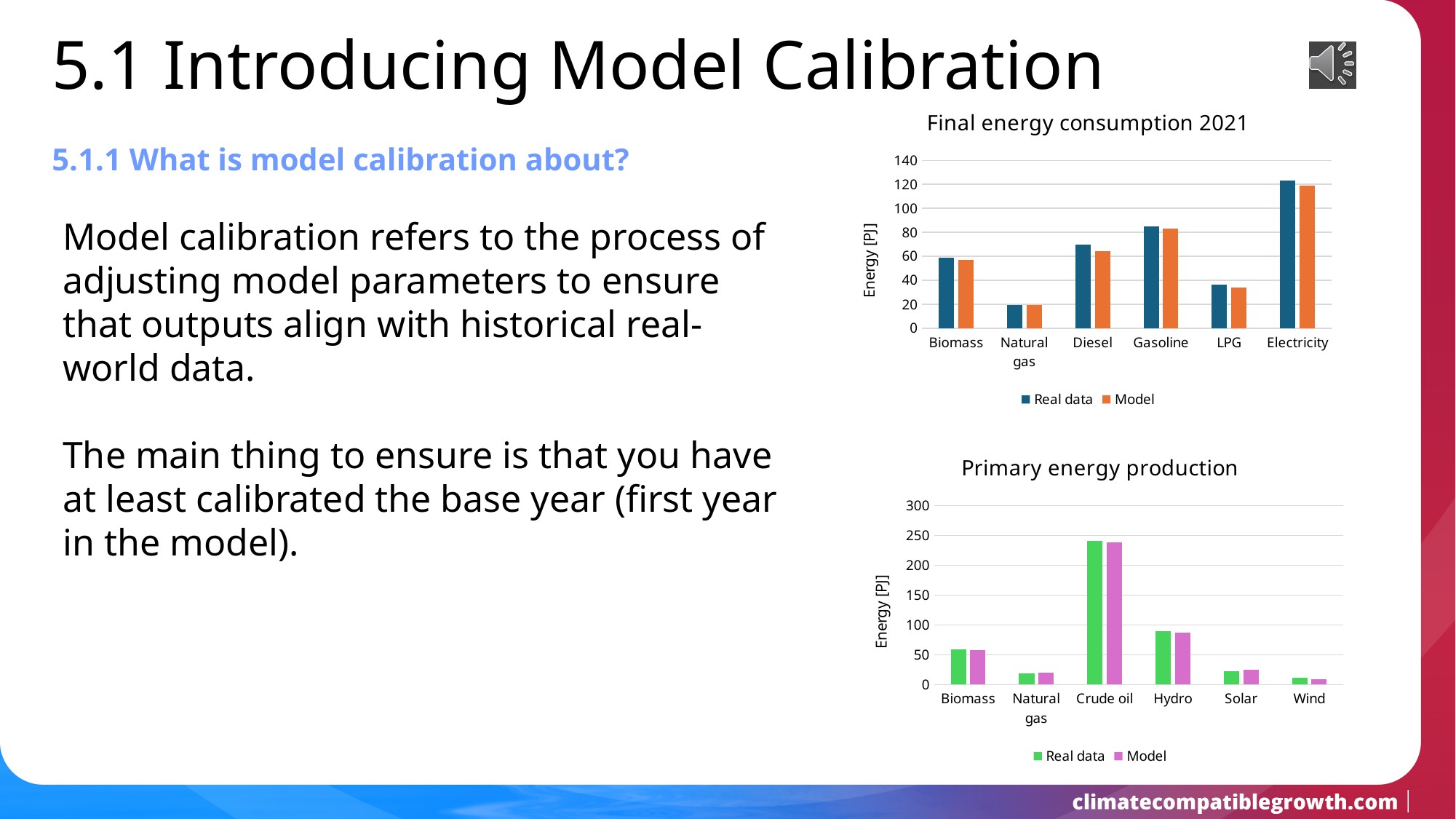
What kind of chart is the 'Final energy consumption 2021' chart? bar chart In the 'Final energy consumption 2021' chart, which category has the lowest Real data value? Natural gas In the 'Primary energy production' chart, which category has the lowest Real data value? Wind What is the y-axis label of the 'Primary energy production' chart? Energy [PJ] In the 'Final energy consumption 2021' chart, which is larger: the Real data value for Gasoline or the Real data value for LPG? Gasoline In the 'Final energy consumption 2021' chart, which category has the highest Real data value? Electricity How many series does the legend of the 'Primary energy production' chart list? 2 In the 'Final energy consumption 2021' chart, is the Real data value for Electricity greater or less than 100? greater In the 'Final energy consumption 2021' chart, is the Model value for Natural gas greater or less than 40? less How many categories are shown on the x axis of the 'Final energy consumption 2021' chart? 6 In the 'Primary energy production' chart, is the Model value for Crude oil greater or less than 200? greater In the 'Primary energy production' chart, which category has the highest Real data value? Crude oil